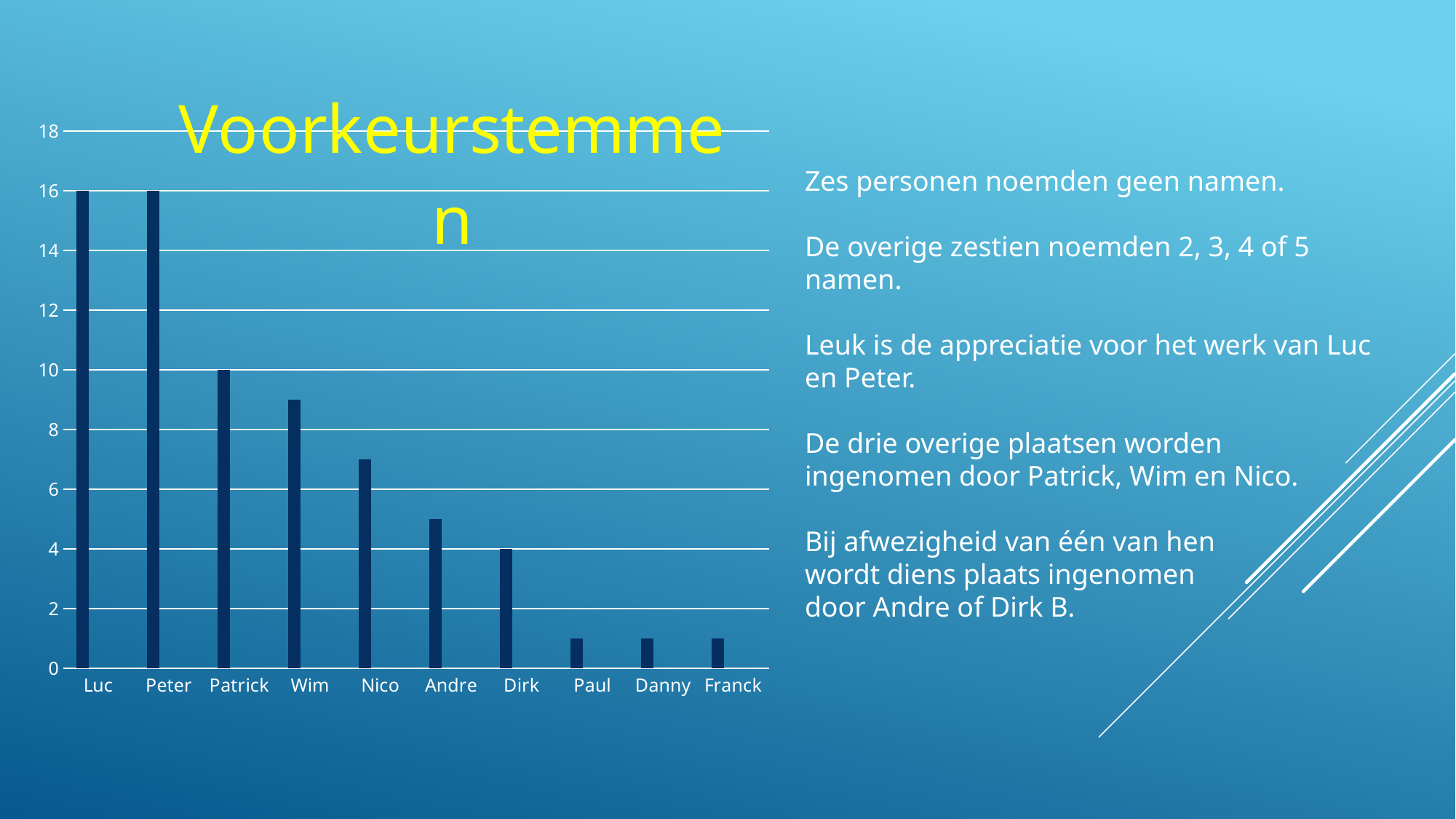
What kind of chart is shown on the slide? bar chart How many categories are shown on the x axis? 10 What is the difference between the values for Luc and Patrick? 6 Is the value for Nico greater or less than 8? less What is the value for Luc? 16 What is the value for Dirk? 4 Is the value for Wim greater or less than 8? greater What is the value for Peter? 16 What is the value for Patrick? 10 Which is larger, the value for Nico or the value for Andre? Nico Is the value for Paul greater or less than 2? less